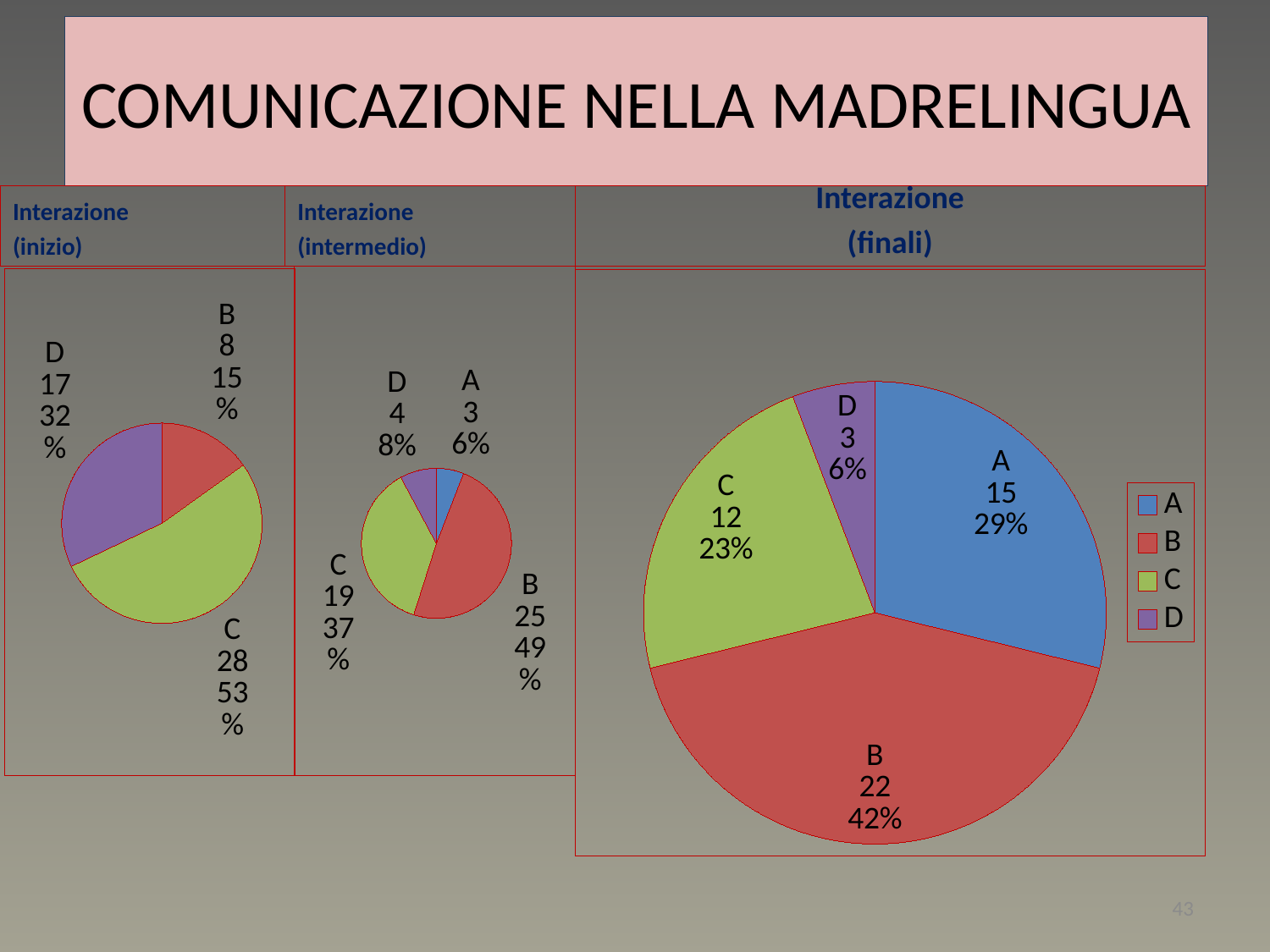
In the 'Interazione (inizio)' pie chart, what value is shown for category C? 28 What kind of chart is used for 'Interazione (inizio)'? Pie chart In the 'Interazione (inizio)' pie chart, which category has the largest share? C In the 'Interazione (finali)' pie chart, what colour is the slice for category D? Purple In the 'Interazione (intermedio)' pie chart, what percentage share does category B have? 49% In the 'Interazione (finali)' pie chart, which category has the largest value? B How many entries does the legend of the 'Interazione (finali)' chart list? 4 In the 'Interazione (finali)' pie chart, what is the difference between the values for B and C? 10 In the 'Interazione (intermedio)' pie chart, which category has the smallest value? A In the 'Interazione (intermedio)' pie chart, which is larger, the value for C or the value for D? C In the 'Interazione (finali)' pie chart, what percentage share does category A have? 29% In the 'Interazione (finali)' pie chart, what value is shown for category B? 22